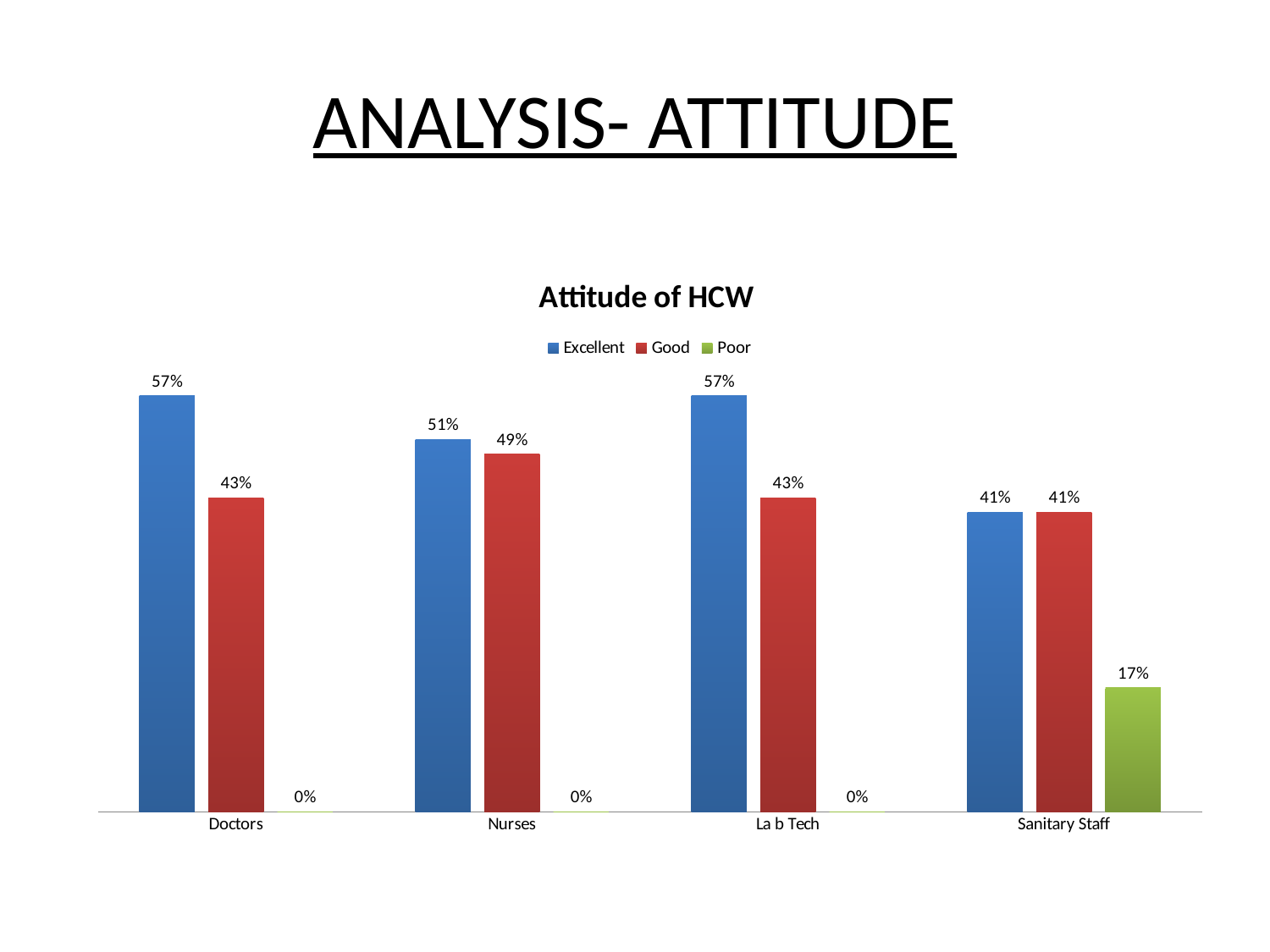
Which category has the highest Good value? Nurses What is the Good value for Nurses? 49% How many series does the legend list? 3 What is the Poor value for Sanitary Staff? 17% What is the Excellent value for Doctors? 57% What is the difference between the Excellent and Good values for Doctors? 14% How many categories are shown on the x axis? 4 What is the Good value for Lab Tech? 43% What kind of chart is shown? Bar chart What is the title of the chart? Attitude of HCW Which is larger, the Excellent value for Nurses or the Excellent value for Lab Tech? Lab Tech Which category has the lowest Excellent value? Sanitary Staff